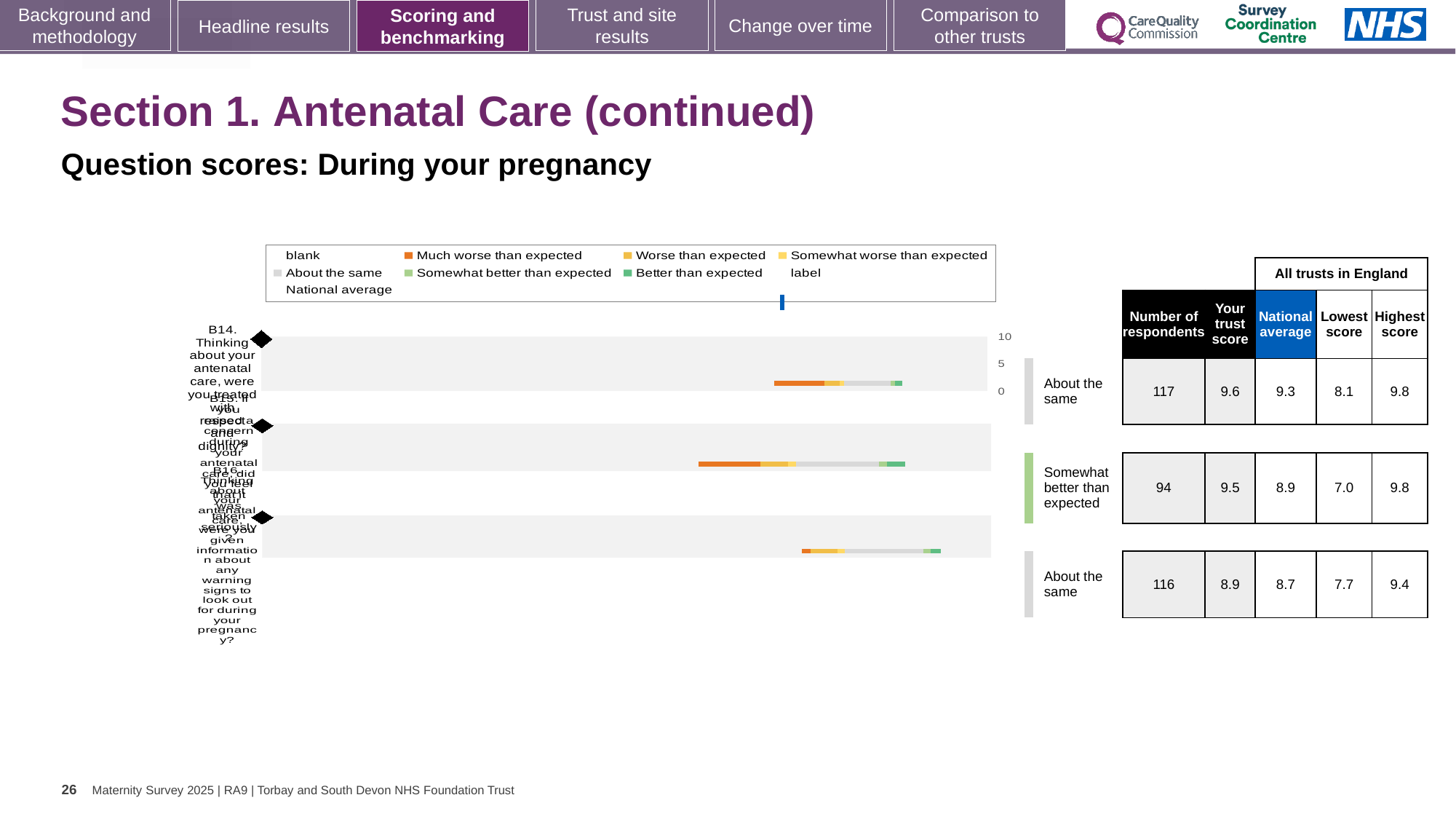
What is the highest value shown on the chart's score axis? 10 Which is larger: the trust score for the first question row or for the third question row? The first row (9.6) What kind of chart is shown on the slide? Bar chart What colour does the legend use for 'Much worse than expected'? Orange How many question rows (bars) does the chart show? 3 In the table beside the chart, what is the number of respondents for the first question row? 117 For the first question row, how much higher is the trust score than the national average? 0.3 In the table beside the chart, what is the highest score for the third question row? 9.4 What benchmark category is shown for the second question row? Somewhat better than expected In the table beside the chart, which question row has the highest number of respondents? The first row (117) In the table beside the chart, which question row has the lowest 'Lowest score' value? The second row (7.0) In the table beside the chart, what is the trust score for the second question row? 9.5